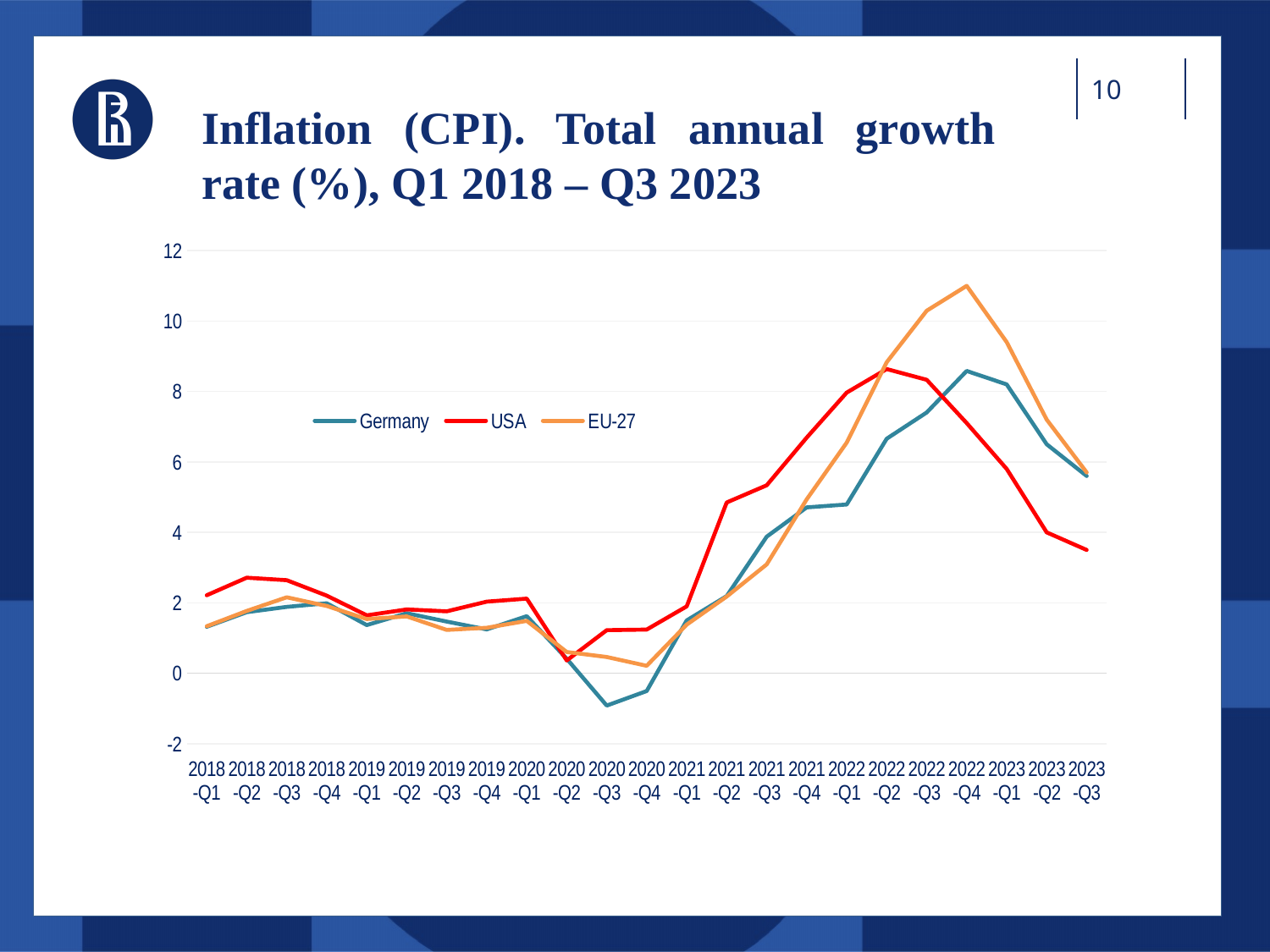
Which series reaches the highest value on the chart? EU-27 What colour is the USA line in the chart? red How many quarters are plotted along the x axis? 23 Does the USA series rise or fall from 2022-Q2 to 2023-Q3? fall Is the value for Germany in 2020-Q3 greater or less than 0? less Which is larger in 2023-Q3, the value for Germany or the value for USA? Germany Which series drops to the lowest value on the chart? Germany What kind of chart is shown on the slide? line chart How many series does the legend list? 3 In which quarter does the EU-27 series reach its peak? 2022-Q4 In which quarter does the Germany series reach its lowest value? 2020-Q3 Is the value for EU-27 in 2022-Q4 greater or less than 10? greater